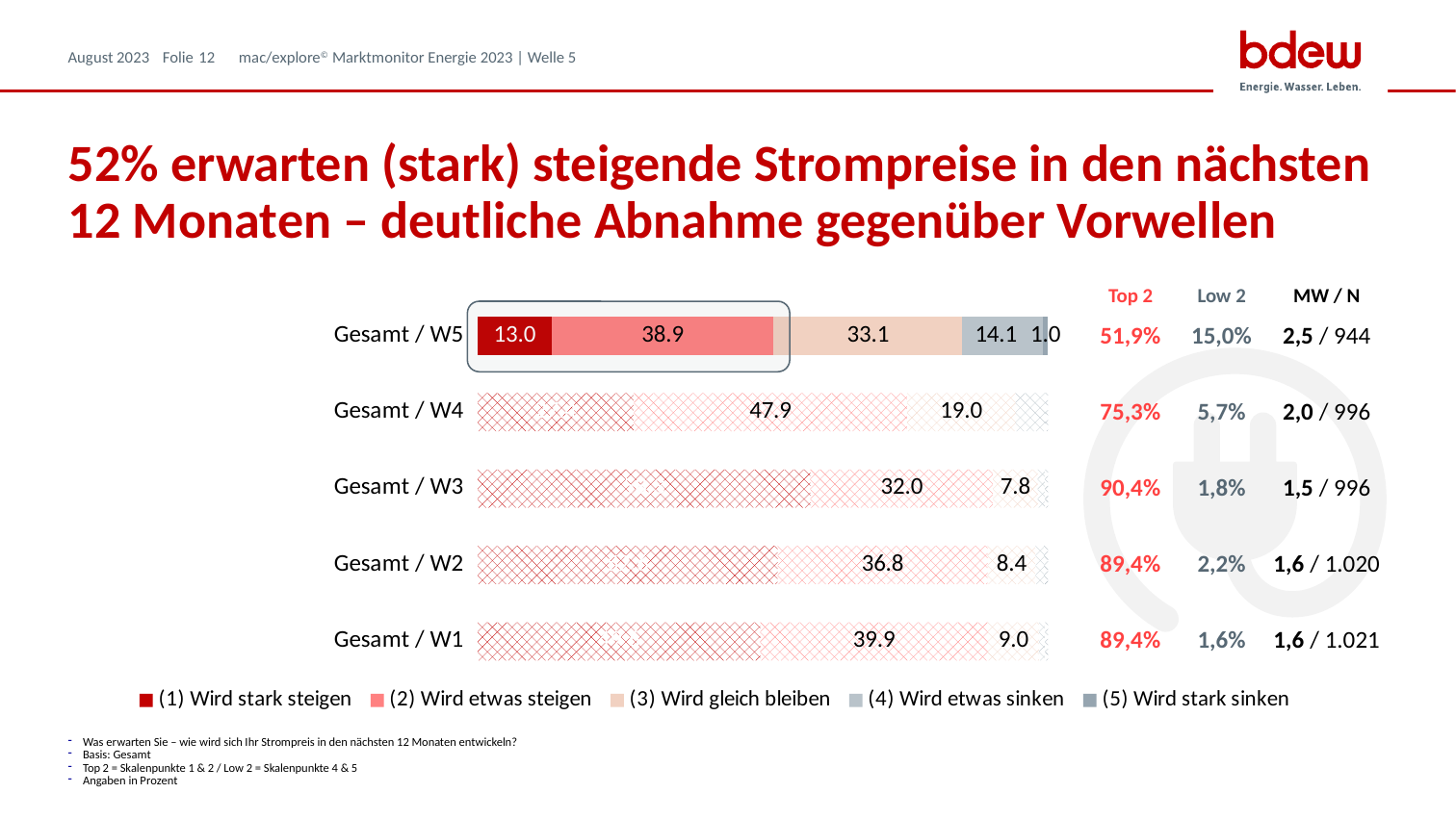
In the Gesamt / W5 bar, which is larger: "(3) Wird gleich bleiben" or "(4) Wird etwas sinken"? (3) Wird gleich bleiben What is the value for "(1) Wird stark steigen" in the Gesamt / W5 bar? 13.0 Which segment of the Gesamt / W5 bar has the largest value? (2) Wird etwas steigen What is the Top 2 value shown for Gesamt / W5? 51,9% What is the value for "(4) Wird etwas sinken" in the Gesamt / W5 bar? 14.1 Which segment of the Gesamt / W5 bar has the smallest value? (5) Wird stark sinken In the Gesamt / W5 bar, how much larger is "(2) Wird etwas steigen" than "(1) Wird stark steigen"? 25.9 What is the value for "(2) Wird etwas steigen" in the Gesamt / W5 bar? 38.9 What is the value for "(3) Wird gleich bleiben" in the Gesamt / W5 bar? 33.1 How many bars (categories) does the chart show? 5 How many series does the legend list? 5 What kind of chart is shown on the slide? Stacked bar chart